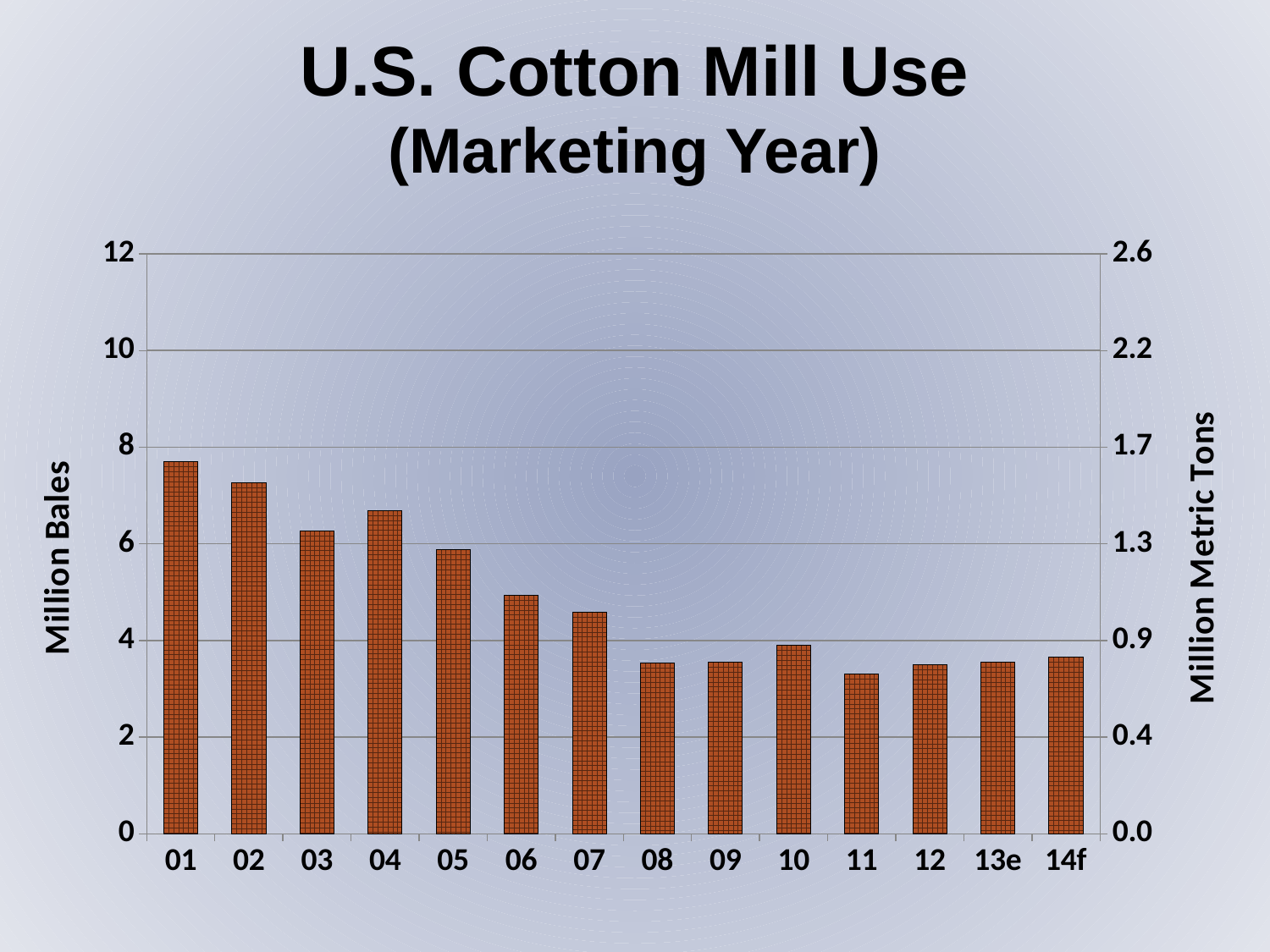
Which is larger, the value for 03 or the value for 04? 04 What kind of chart is shown on the slide? Bar chart Is the value for 11 greater or less than 4 million bales? less Is the value for 07 greater or less than 4 million bales? greater How many marketing years are plotted on the chart? 14 Do the values generally rise or fall from 01 to 14f? Fall Which marketing year has the highest cotton mill use? 01 Is the value for 06 greater or less than 6 million bales? less Which marketing year has the lowest cotton mill use? 11 What is the label on the left vertical axis? Million Bales Which is larger, the value for 10 or the value for 11? 10